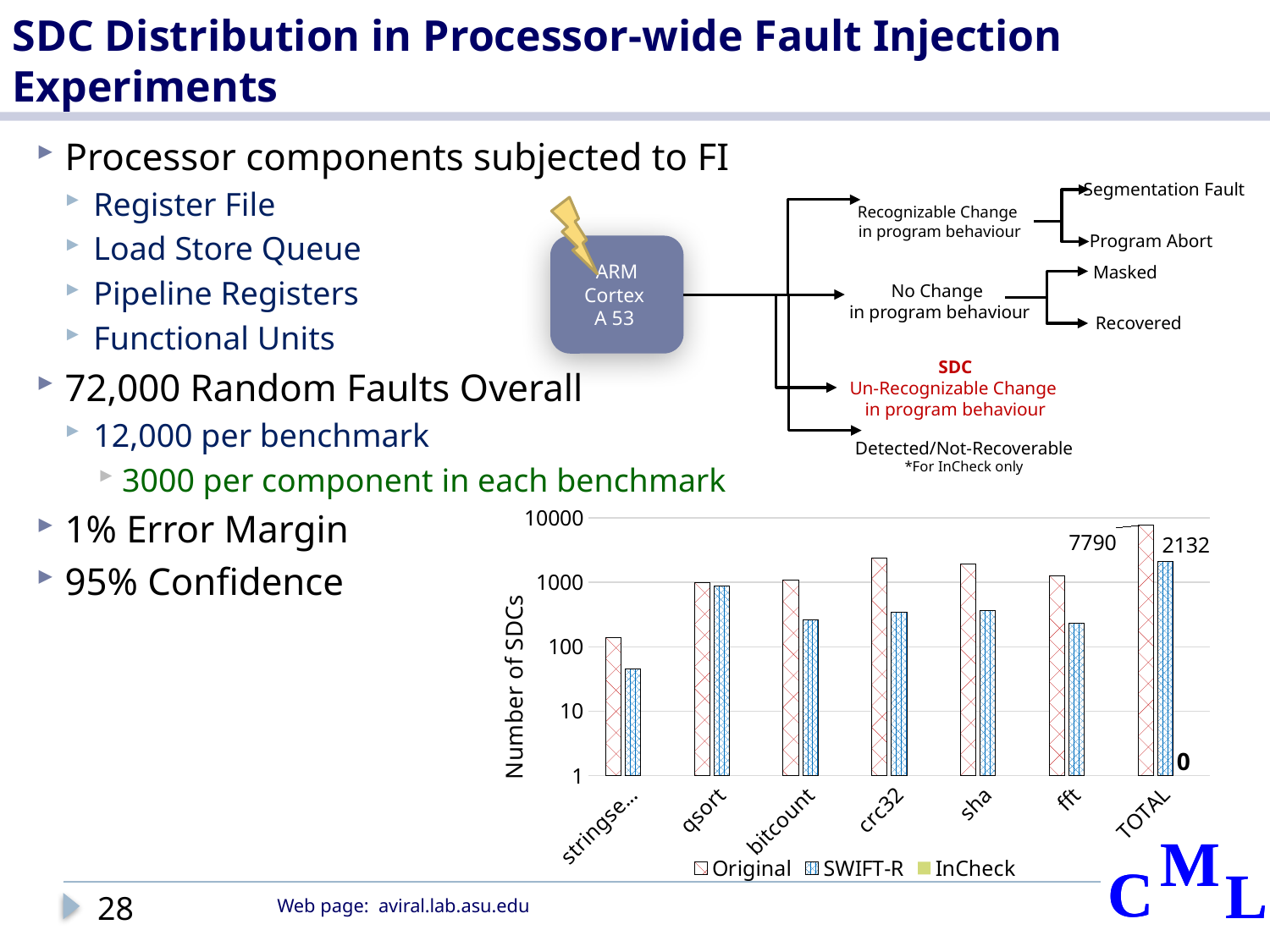
What is the value of the SWIFT-R series for TOTAL? 2132 Is the SWIFT-R value for stringse... greater or less than 100? less What is the difference between the Original and SWIFT-R values for TOTAL? 5658 Which is larger for bitcount, the Original value or the SWIFT-R value? Original What kind of chart is shown on the slide? bar chart Is the Original value for crc32 greater or less than 1000? greater How many series does the legend list? 3 What is the value of the InCheck series for TOTAL? 0 How many categories are shown on the x axis? 7 What is the label of the y axis? Number of SDCs What is the value of the Original series for TOTAL? 7790 Among the benchmarks (excluding TOTAL), which has the lowest Original value? stringse...